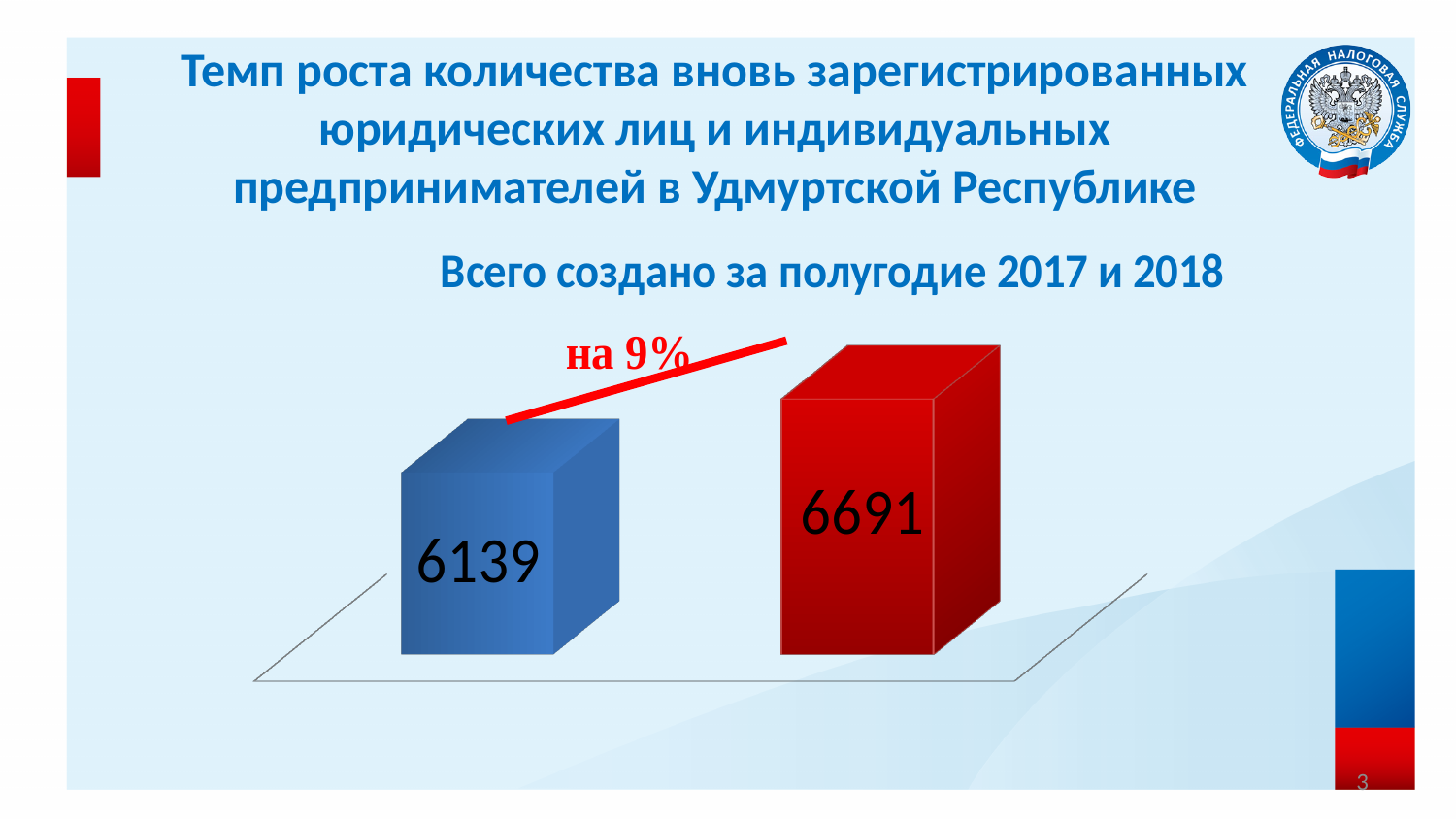
What is the difference between the value on the red bar and the value on the blue bar? 552 Which bar shows the highest value, the blue one or the red one? the red bar What value is printed on the blue bar on the left of the chart? 6139 What kind of chart is shown on the slide? bar chart What percentage growth is written in red above the bars? на 9% What is the subtitle written directly above the chart? Всего создано за полугодие 2017 и 2018 Which bar shows the lowest value, the blue one or the red one? the blue bar Do the values rise or fall from the left bar to the right bar? rise What value is printed on the red bar on the right of the chart? 6691 How many bars are plotted in the chart? 2 Is the value on the red bar larger or smaller than the value on the blue bar? larger